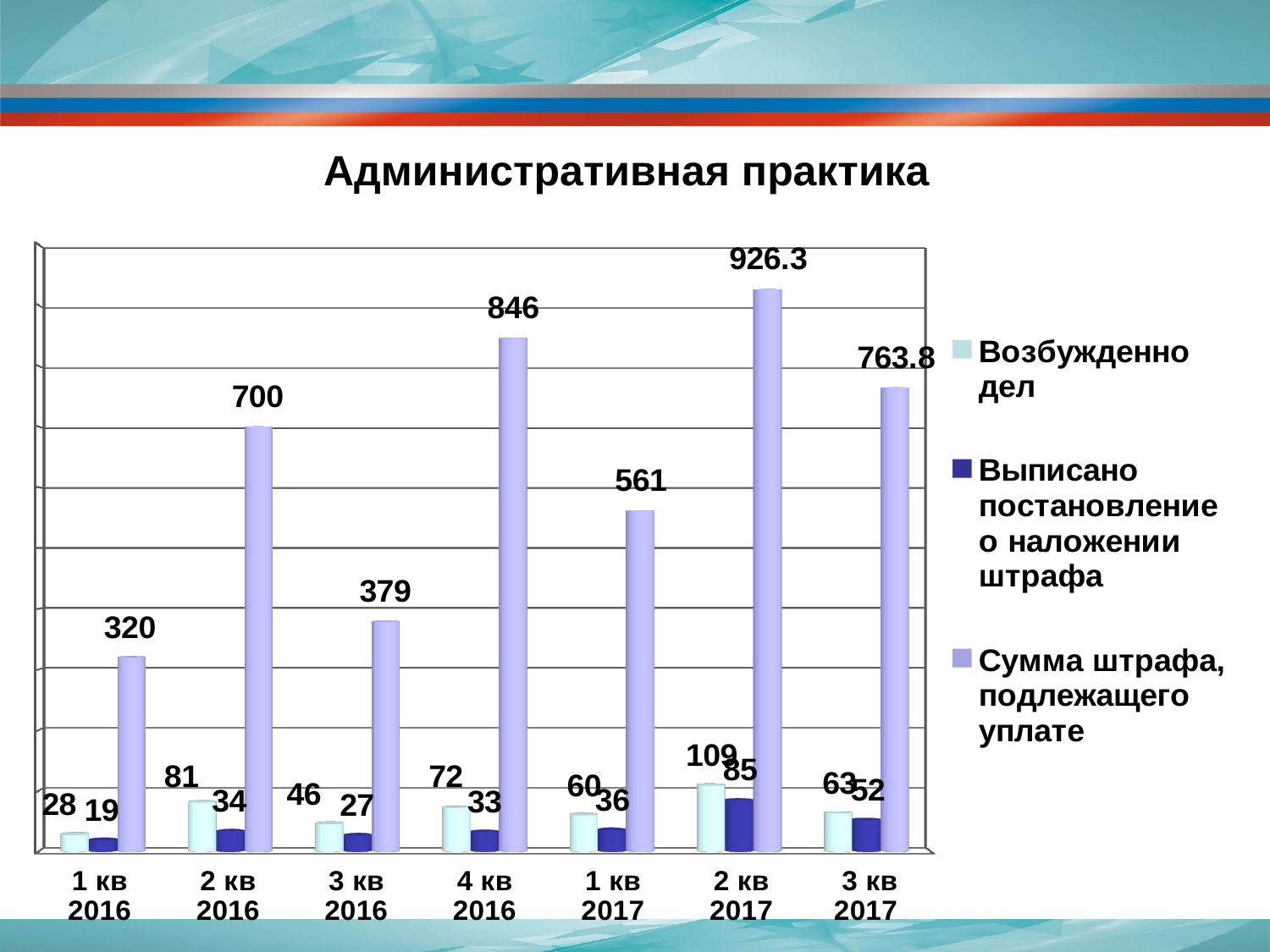
What is the value of "Выписано постановление о наложении штрафа" for 1 кв 2017? 36 What is the value of "Возбужденно дел" for 2 кв 2016? 81 Which quarter has the highest value of "Сумма штрафа, подлежащего уплате"? 2 кв 2017 What is the value of "Сумма штрафа, подлежащего уплате" for 2 кв 2017? 926.3 How many series does the legend list? 3 What is the title of the chart? Административная практика Which is larger: "Возбужденно дел" for 4 кв 2016 or for 1 кв 2017? 4 кв 2016 What is the value of "Сумма штрафа, подлежащего уплате" for 3 кв 2017? 763.8 How many quarters are shown on the x axis? 7 What is the difference between "Сумма штрафа, подлежащего уплате" for 4 кв 2016 and 2 кв 2016? 146 Which quarter has the lowest value of "Возбужденно дел"? 1 кв 2016 What kind of chart is shown on the slide? Bar chart